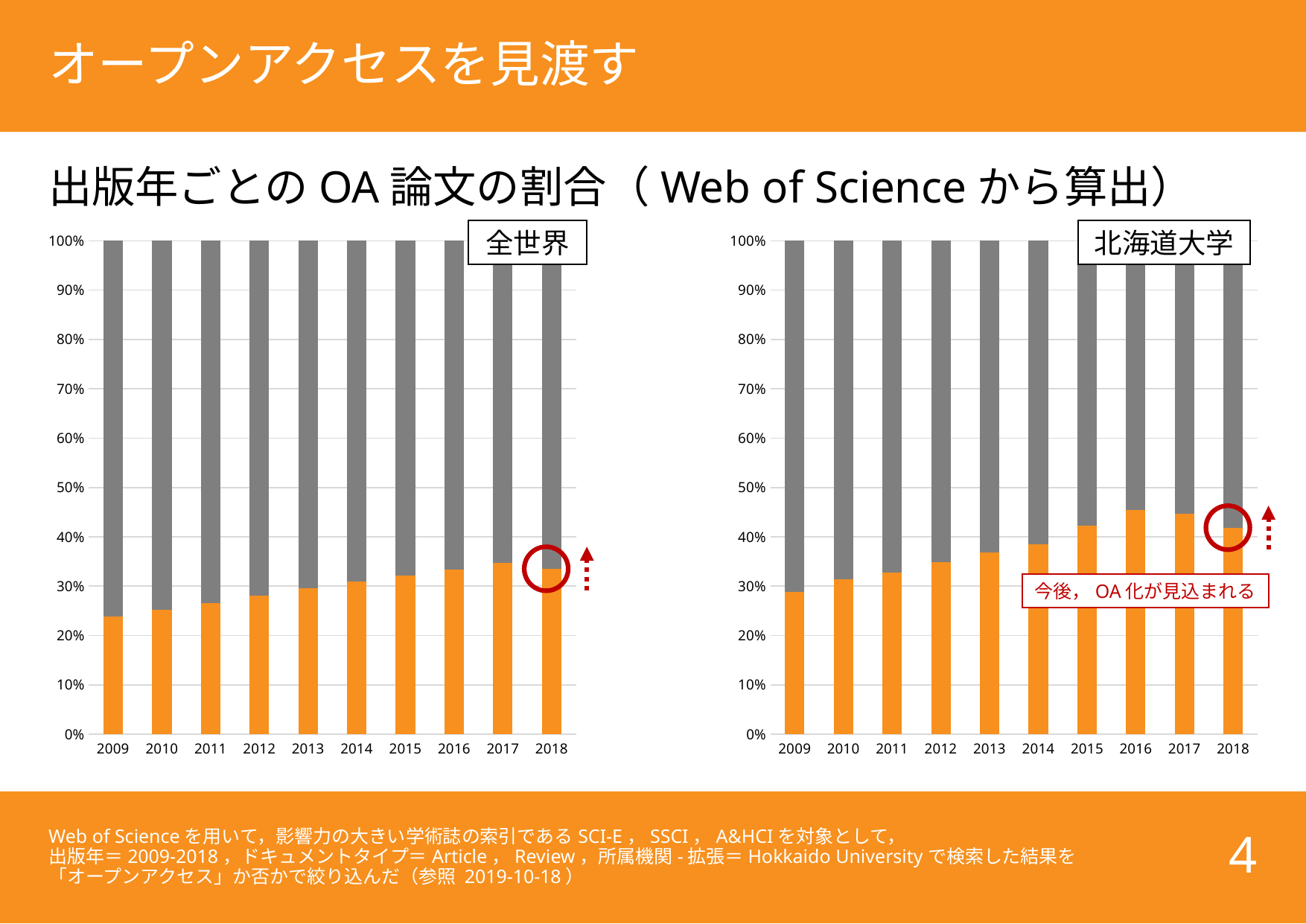
In the 全世界 chart on the left, which year has the smallest orange (OA) portion? 2009 In the 全世界 chart on the left, is the orange (OA) value for 2009 greater or less than 30%? less What is the label in the box at the top right of the right-hand chart? 北海道大学 In the 北海道大学 chart on the right, which year has the larger orange (OA) portion, 2009 or 2016? 2016 What kind of chart is the 全世界 chart on the left? stacked bar chart In the 北海道大学 chart on the right, is the orange (OA) value for 2013 greater or less than 40%? less In the 全世界 chart on the left, which year has the larger orange (OA) portion, 2009 or 2017? 2017 In the 全世界 chart on the left, is the orange (OA) value for 2018 greater or less than 30%? greater How many years are shown on the x axis of the 北海道大学 chart on the right? 10 In the 北海道大学 chart on the right, which year has the smallest orange (OA) portion? 2009 In the 全世界 chart on the left, does the orange (OA) portion generally rise or fall from 2009 to 2017? rise